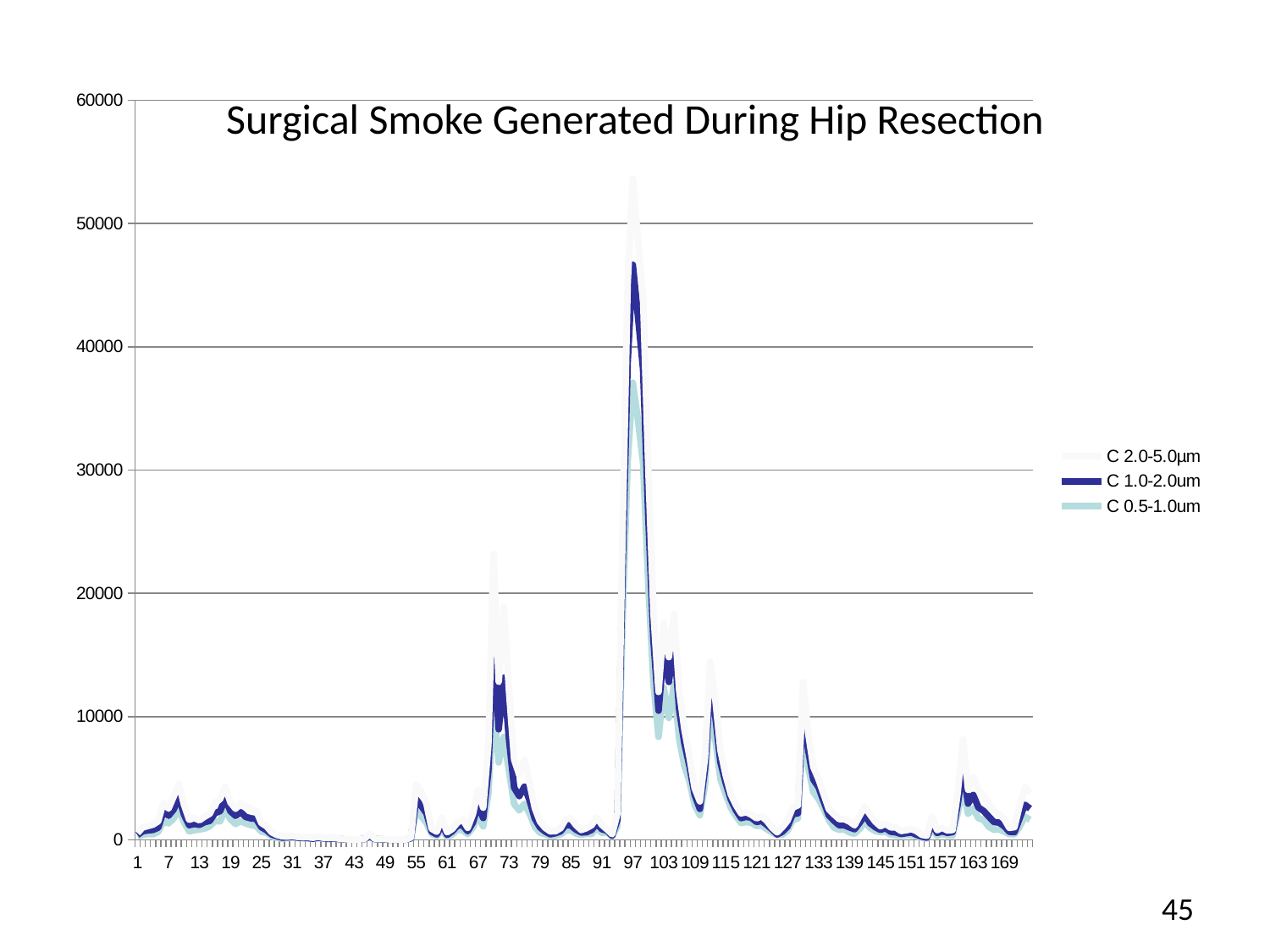
What kind of chart is shown on the slide? line chart Is the highest peak of the C 1.0-2.0um series greater or less than 50000? less Which series is listed first in the legend? C 2.0-5.0μm Are the values for the C 1.0-2.0um series between x = 31 and x = 49 greater or less than 10000? less What is the title of the chart? Surgical Smoke Generated During Hip Resection Is the highest peak of the C 0.5-1.0um series greater or less than 40000? less How many series does the legend list? 3